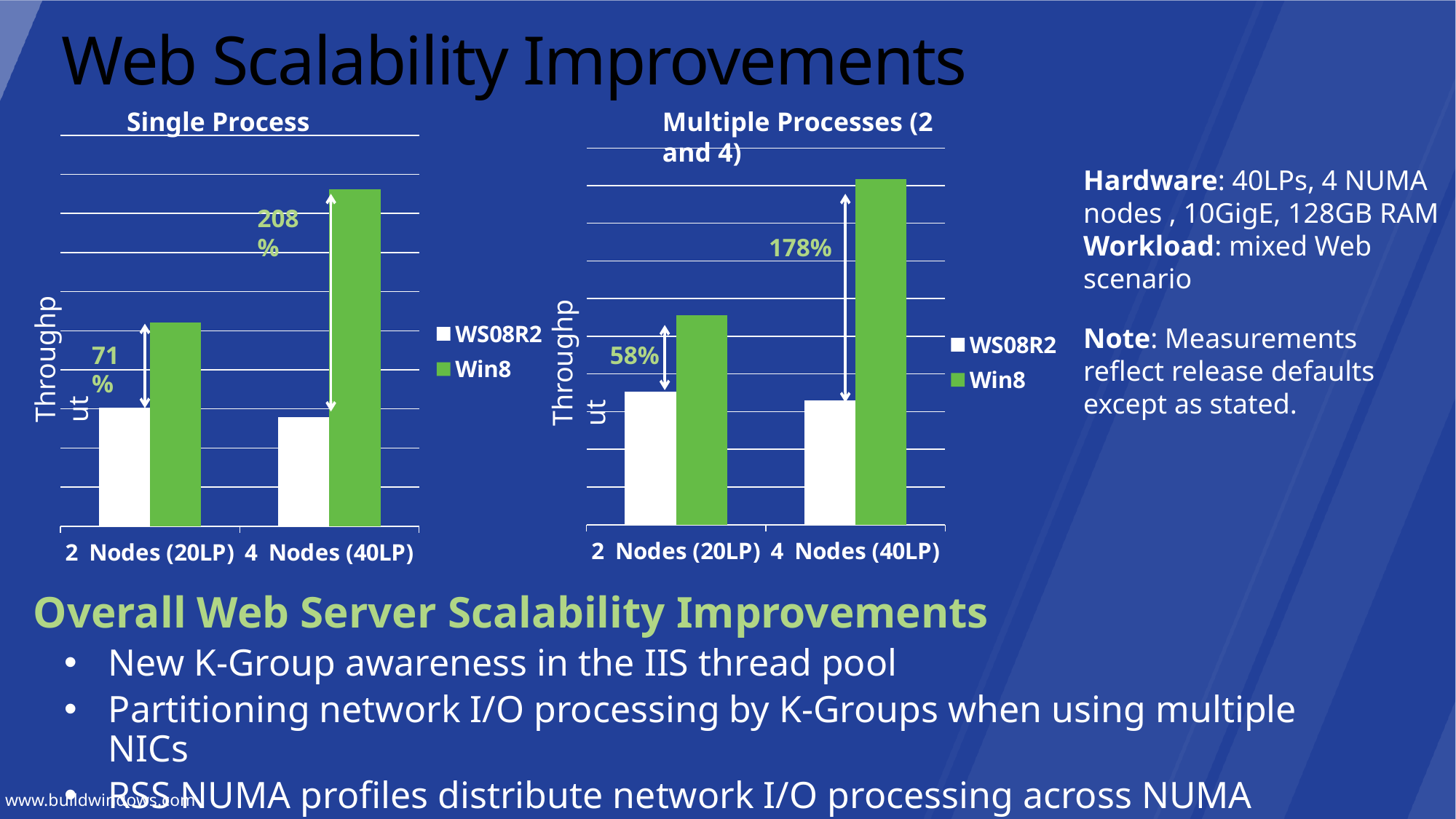
In the Single Process chart, what percentage improvement is labelled for 4 Nodes (40LP)? 208% What is the title of the chart on the left? Single Process In the Multiple Processes (2 and 4) chart, what percentage improvement is labelled for 2 Nodes (20LP)? 58% In the Single Process chart, what percentage improvement is labelled for 2 Nodes (20LP)? 71% How many series does the legend of the Multiple Processes (2 and 4) chart list? 2 What kind of chart is the Single Process chart? bar chart How many node categories are shown on the x axis of the Single Process chart? 2 In the Multiple Processes (2 and 4) chart, does the Win8 throughput rise or fall from 2 Nodes (20LP) to 4 Nodes (40LP)? rise In the Multiple Processes (2 and 4) chart, which bar is the tallest? Win8 at 4 Nodes (40LP) In the Single Process chart, which series has the taller bar at 4 Nodes (40LP), WS08R2 or Win8? Win8 Which two series are listed in the legend of the Single Process chart? WS08R2 and Win8 In the Multiple Processes (2 and 4) chart, what percentage improvement is labelled for 4 Nodes (40LP)? 178%